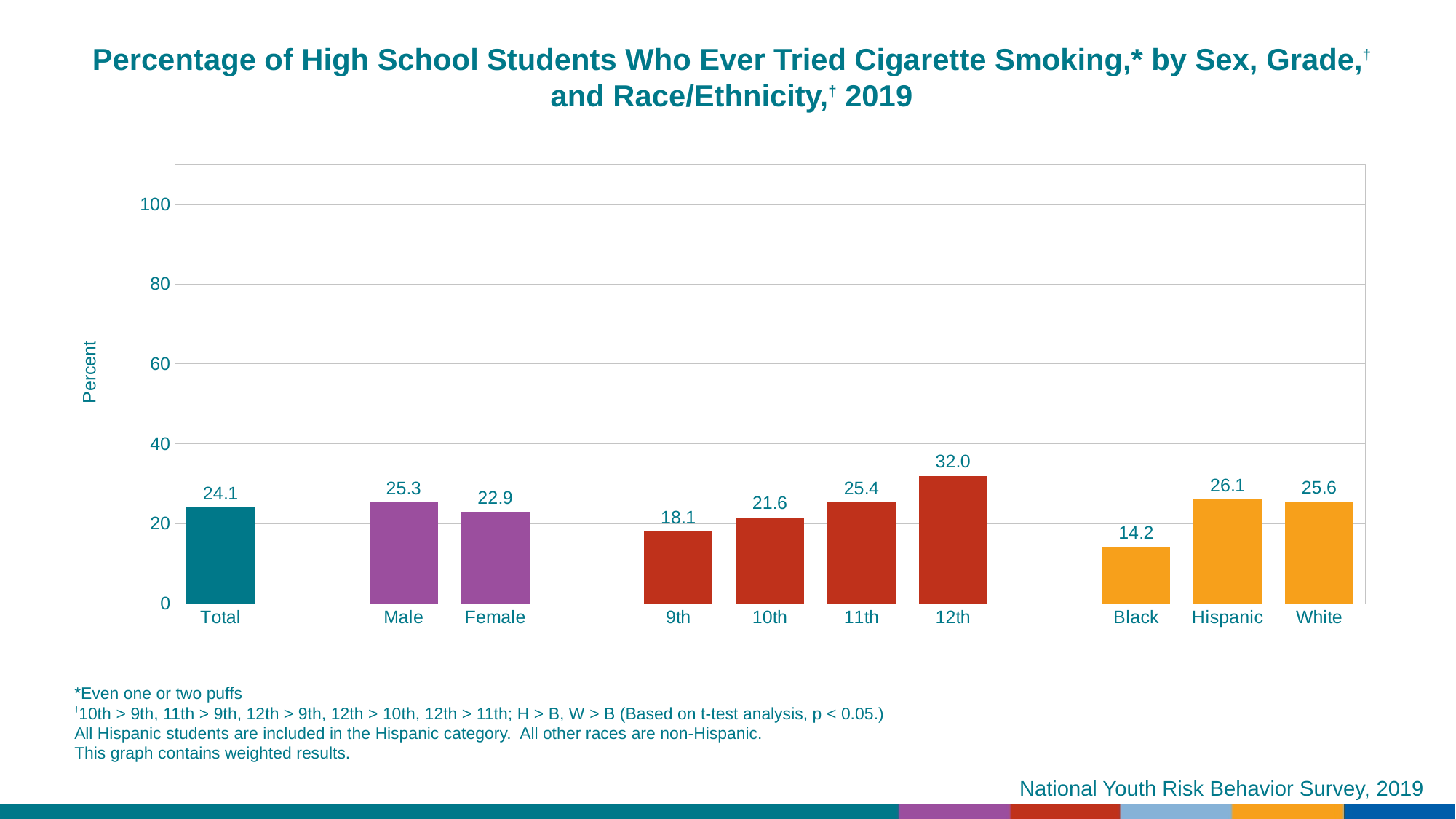
Which is larger, the value for Hispanic or the value for Black? Hispanic What kind of chart is this? bar chart Is the value for 12th grade greater or less than 40? less What is the value for Black students? 14.2 What is the difference between the values for Male and Female? 2.4 How many categories are shown on the x axis? 10 Which category has the highest value? 12th Do the values rise or fall from 9th grade to 12th grade? rise Which category has the lowest value? Black What percentage of 12th grade students ever tried cigarette smoking? 32.0 What is the value for Total? 24.1 What is the difference between the values for 12th and 9th grade? 13.9